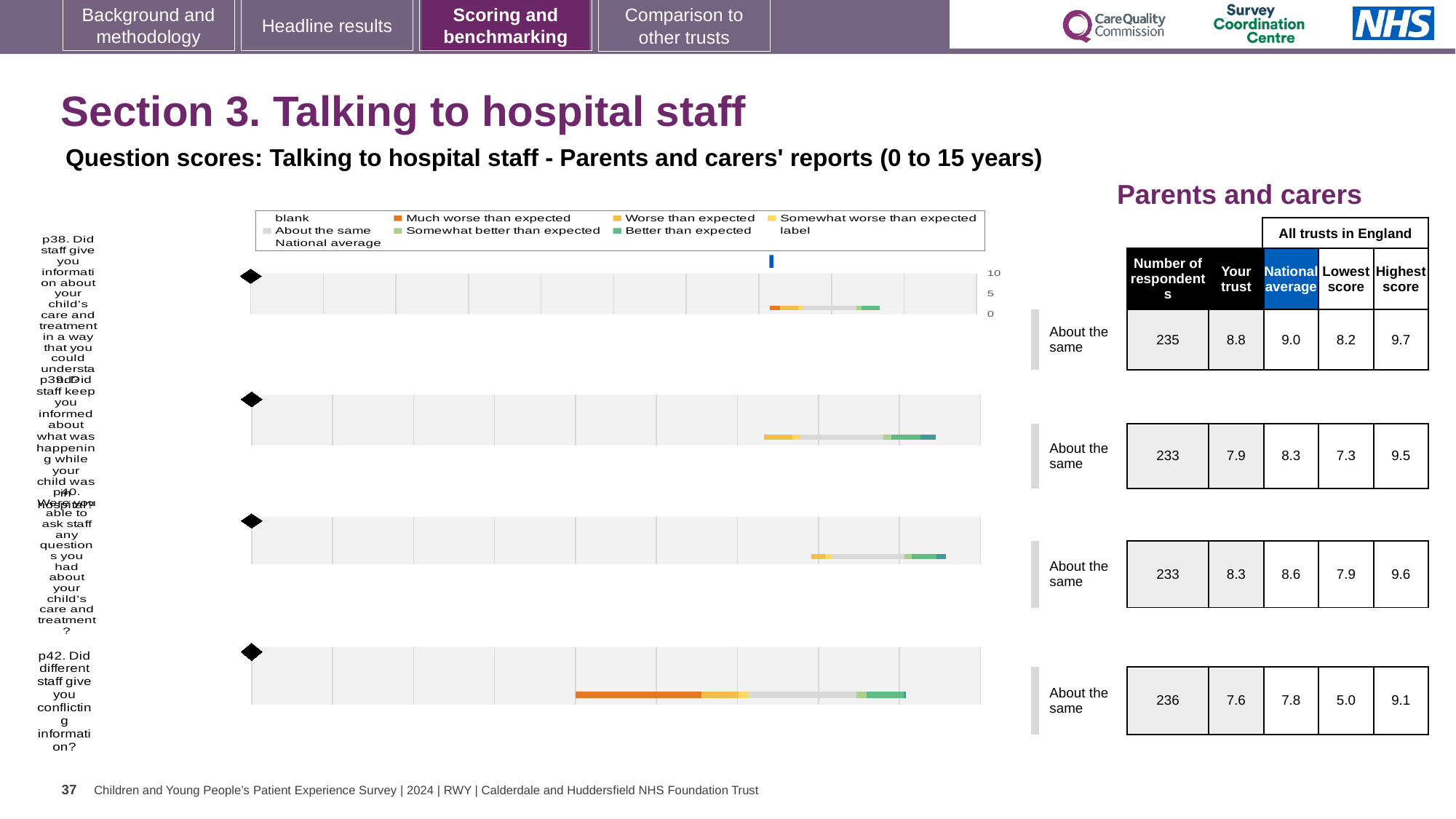
For question p39, which is larger: the 'Your trust' score or the national average? National average How many questions (chart rows) are plotted on the slide? 4 For question p42 (Did different staff give you conflicting information?), what is the lowest score among all trusts in England? 5.0 Which question has the highest 'Your trust' score? p38 Which question has the lowest 'Your trust' score? p42 For question p39 (Did staff keep you informed about what was happening while your child was in hospital?), how many respondents were there? 233 For question p40 (Were you able to ask staff any questions you had about your child's care and treatment?), what is the highest score among all trusts in England? 9.6 For question p42, what is the difference between the highest score and the lowest score among all trusts in England? 4.1 What benchmark category is shown for all four questions on the slide? About the same For question p38 (Did staff give you information about your child's care and treatment in a way that you could understand?), what is the 'Your trust' score? 8.8 For question p38, what is the national average score? 9.0 What kind of chart is used to show the question scores on this slide? bar chart